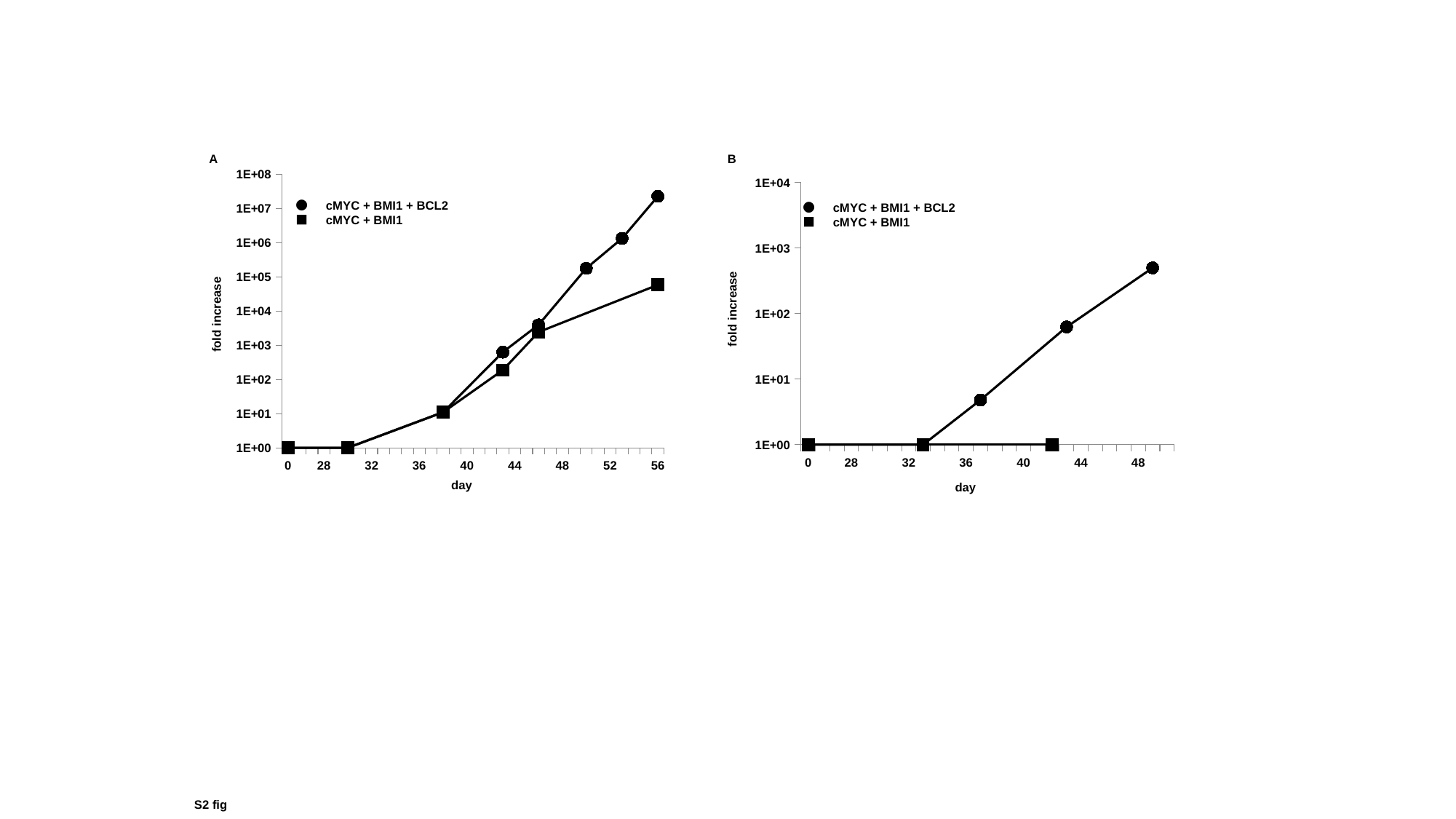
In chart B, what is the fold increase for cMYC + BMI1 at day 42? 1E+00 What is the label of the y axis in chart B? fold increase In chart A, is the fold increase for cMYC + BMI1 at day 56 greater or less than 1E+05? less What kind of chart is chart A (the left chart)? line chart In chart A, does the fold increase for cMYC + BMI1 + BCL2 rise or fall from day 38 to day 56? rise In chart A, is the fold increase for cMYC + BMI1 + BCL2 at day 56 greater or less than 1E+06? greater How many series does the legend of chart A list? 2 In chart B, which series has the higher fold increase at around day 43? cMYC + BMI1 + BCL2 In chart B, how many data points are plotted for the cMYC + BMI1 + BCL2 series? 5 What are the two series named in the legend of chart B? cMYC + BMI1 + BCL2 and cMYC + BMI1 In chart A, which series has the higher fold increase at day 56? cMYC + BMI1 + BCL2 In chart B, is the fold increase for cMYC + BMI1 + BCL2 at its last point (around day 49) greater or less than 1E+03? less